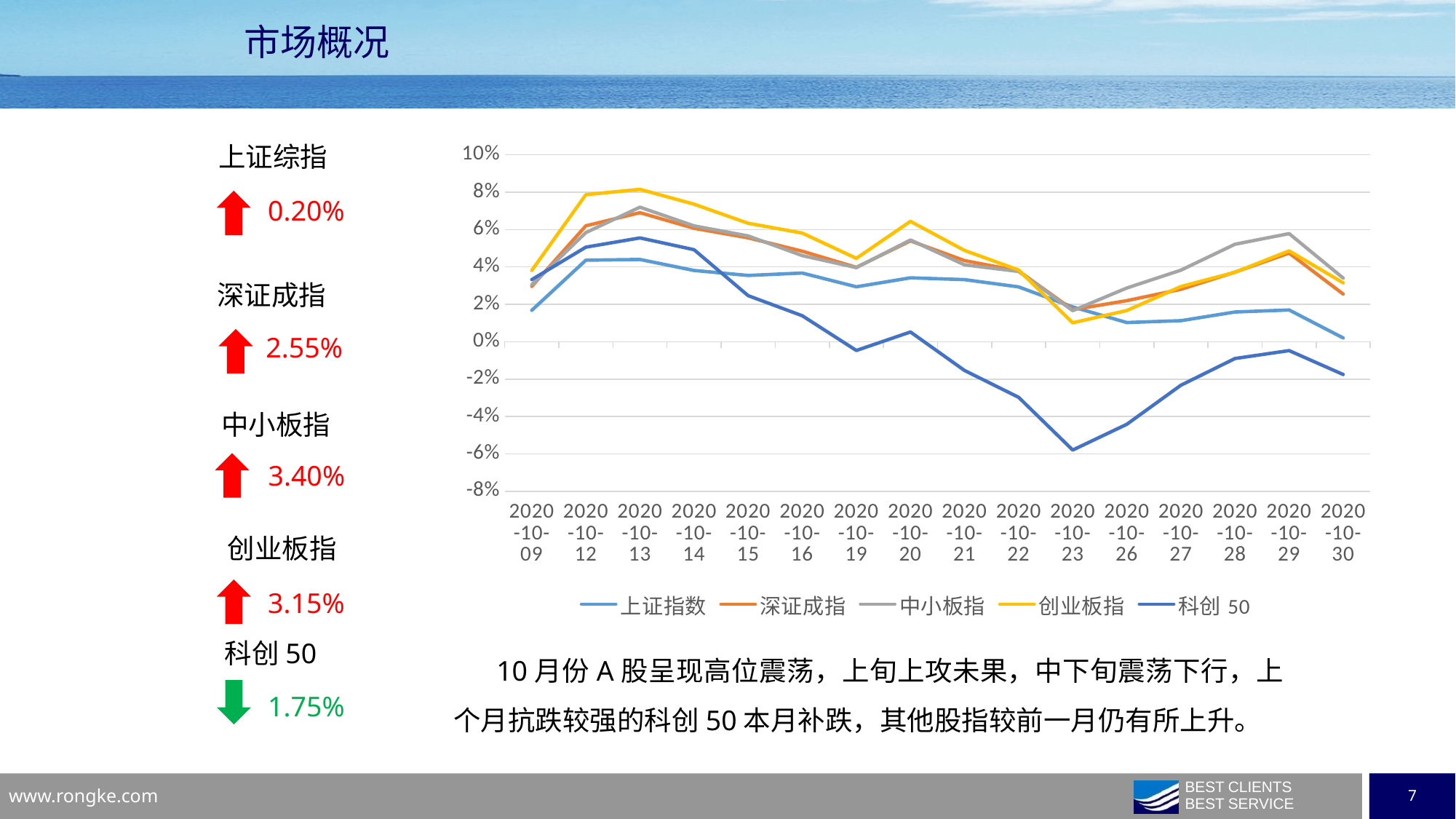
Is the value for 中小板指 on 2020-10-28 greater or less than 4%? greater Which series has the lowest value on 2020-10-30? 科创 50 Which series has the highest value on 2020-10-29? 中小板指 Which series has the lowest value on 2020-10-23? 科创 50 How many dates are plotted along the x axis of the chart? 16 What kind of chart is shown on the slide? line chart On 2020-10-30, which is larger: the value for 上证指数 or the value for 科创 50? 上证指数 Is the value for 科创 50 on 2020-10-23 greater or less than -4%? less Which series has the highest value on 2020-10-13? 创业板指 How many series does the chart legend list? 5 Does the 科创 50 line rise or fall between 2020-10-13 and 2020-10-23? fall Is the value for 创业板指 on 2020-10-13 greater or less than 6%? greater